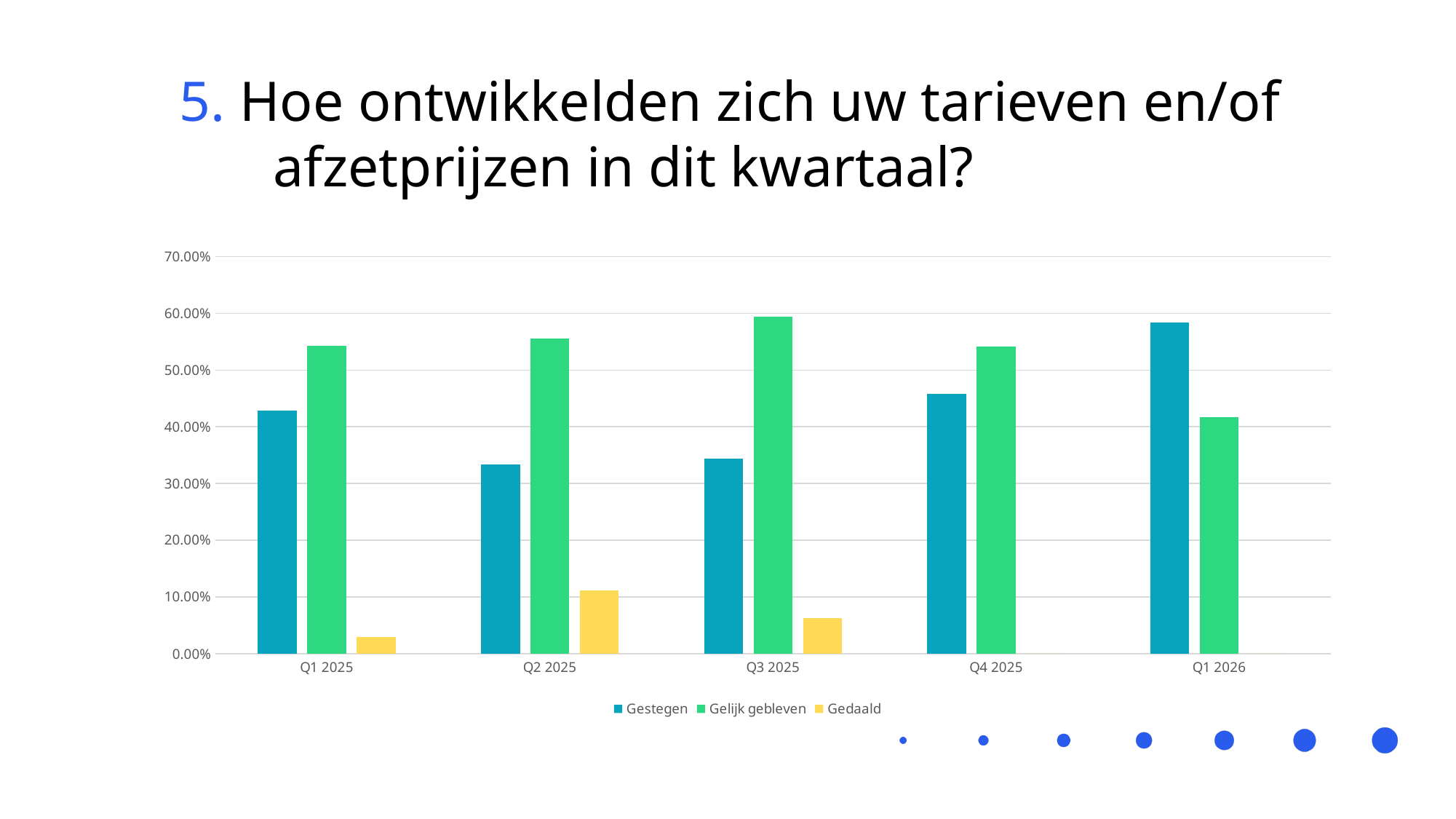
Is the 'Gestegen' value for Q1 2026 greater or less than 50.00%? greater Is the 'Gestegen' value for Q2 2025 greater or less than 40.00%? less In Q1 2025, which is larger: 'Gestegen' or 'Gelijk gebleven'? Gelijk gebleven How many series does the chart's legend list? 3 Is the 'Gelijk gebleven' value for Q1 2026 greater or less than 50.00%? less How many quarters are shown on the x axis of the chart? 5 In which quarter is the 'Gestegen' value highest? Q1 2026 In Q1 2026, which is larger: 'Gestegen' or 'Gelijk gebleven'? Gestegen In which quarter is the 'Gedaald' value highest? Q2 2025 Which colour represents the 'Gedaald' series in the legend? yellow In which quarter is the 'Gelijk gebleven' value highest? Q3 2025 What kind of chart is shown on the slide? bar chart